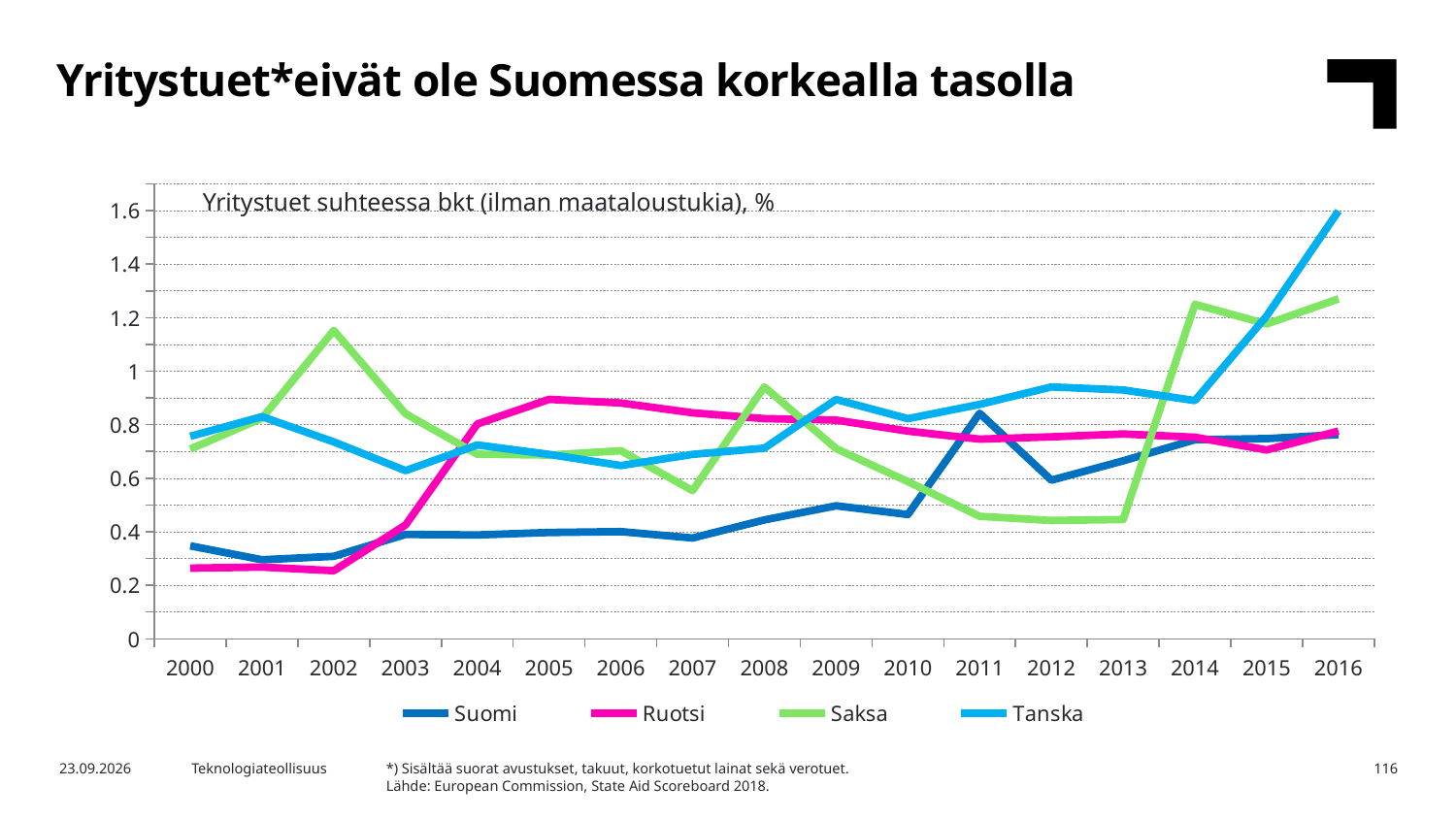
Which is larger in 2002, the value for Saksa or the value for Suomi? Saksa What is the title of the chart? Yritystuet suhteessa bkt (ilman maataloustukia), % Is the value for Tanska in 2016 greater or less than 1.4? greater Does the value for Tanska rise or fall from 2013 to 2016? rise Is the value for Ruotsi in 2000 greater or less than 0.4? less Is the value for Suomi in 2010 greater or less than 0.6? less How many years are shown on the x axis? 17 Which country has the highest value in 2016? Tanska Which country has the highest value in 2002? Saksa What kind of chart is shown on the slide? line chart How many series does the legend list? 4